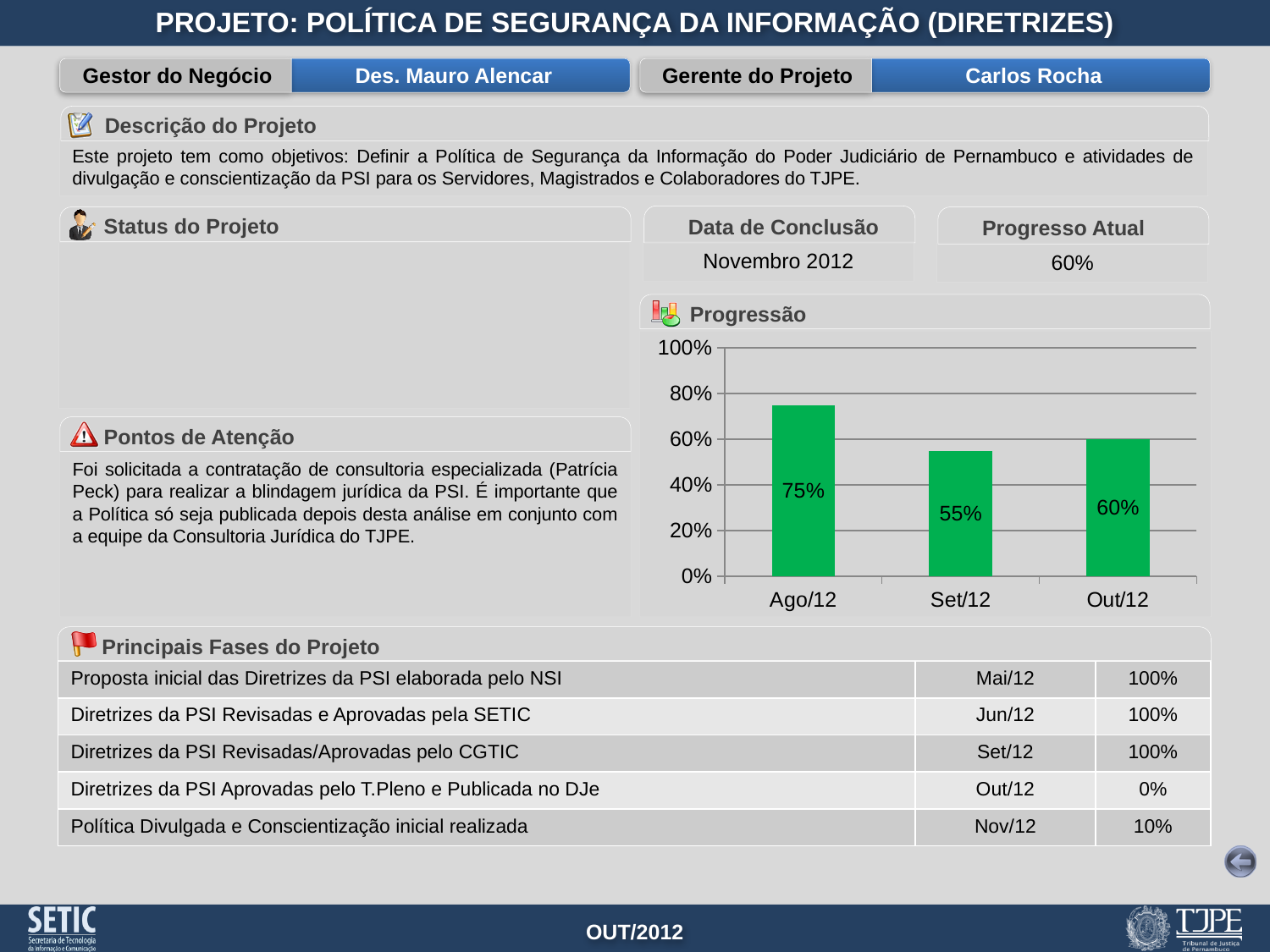
What is the value for Ago/12 in the Progressão chart? 75% What is the difference between the values for Ago/12 and Set/12 in the Progressão chart? 20% What kind of chart is the Progressão chart? bar chart How many months are shown on the x axis of the Progressão chart? 3 What is the title of the chart on the slide? Progressão What is the difference between the values for Out/12 and Set/12 in the Progressão chart? 5% Which month has the highest value in the Progressão chart? Ago/12 What is the value for Out/12 in the Progressão chart? 60% Which is larger in the Progressão chart, the value for Ago/12 or Out/12? Ago/12 What is the value for Set/12 in the Progressão chart? 55% Which month has the lowest value in the Progressão chart? Set/12 Is the value for Set/12 in the Progressão chart greater or less than 60%? less